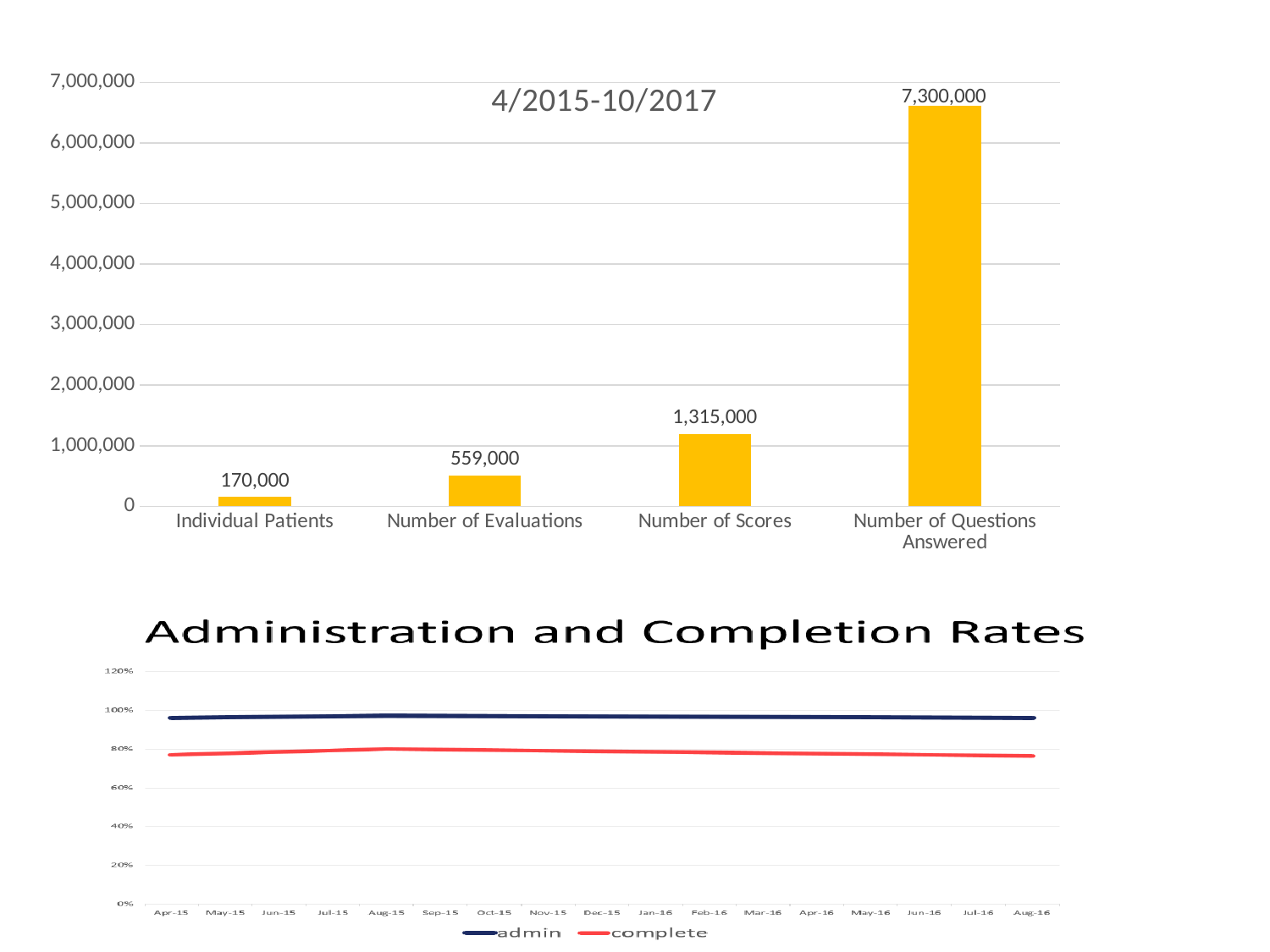
In the chart titled 4/2015-10/2017, what is the value for Number of Scores? 1,315,000 In the chart titled 4/2015-10/2017, what is the difference between Number of Scores and Number of Evaluations? 756,000 In the chart titled 4/2015-10/2017, how many categories are shown? 4 In the Administration and Completion Rates chart, how many series does the legend list? 2 In the chart titled 4/2015-10/2017, which category has the lowest value? Individual Patients In the Administration and Completion Rates chart, is the value for admin in Apr-15 greater or less than 80%? greater In the chart titled 4/2015-10/2017, what is the value for Number of Evaluations? 559,000 In the chart titled 4/2015-10/2017, which category has the highest value? Number of Questions Answered In the Administration and Completion Rates chart, which series is higher in Aug-16: admin or complete? admin What kind of chart is the Administration and Completion Rates chart? Line chart What kind of chart is the chart titled 4/2015-10/2017? Bar chart In the chart titled 4/2015-10/2017, which is larger: Individual Patients or Number of Evaluations? Number of Evaluations